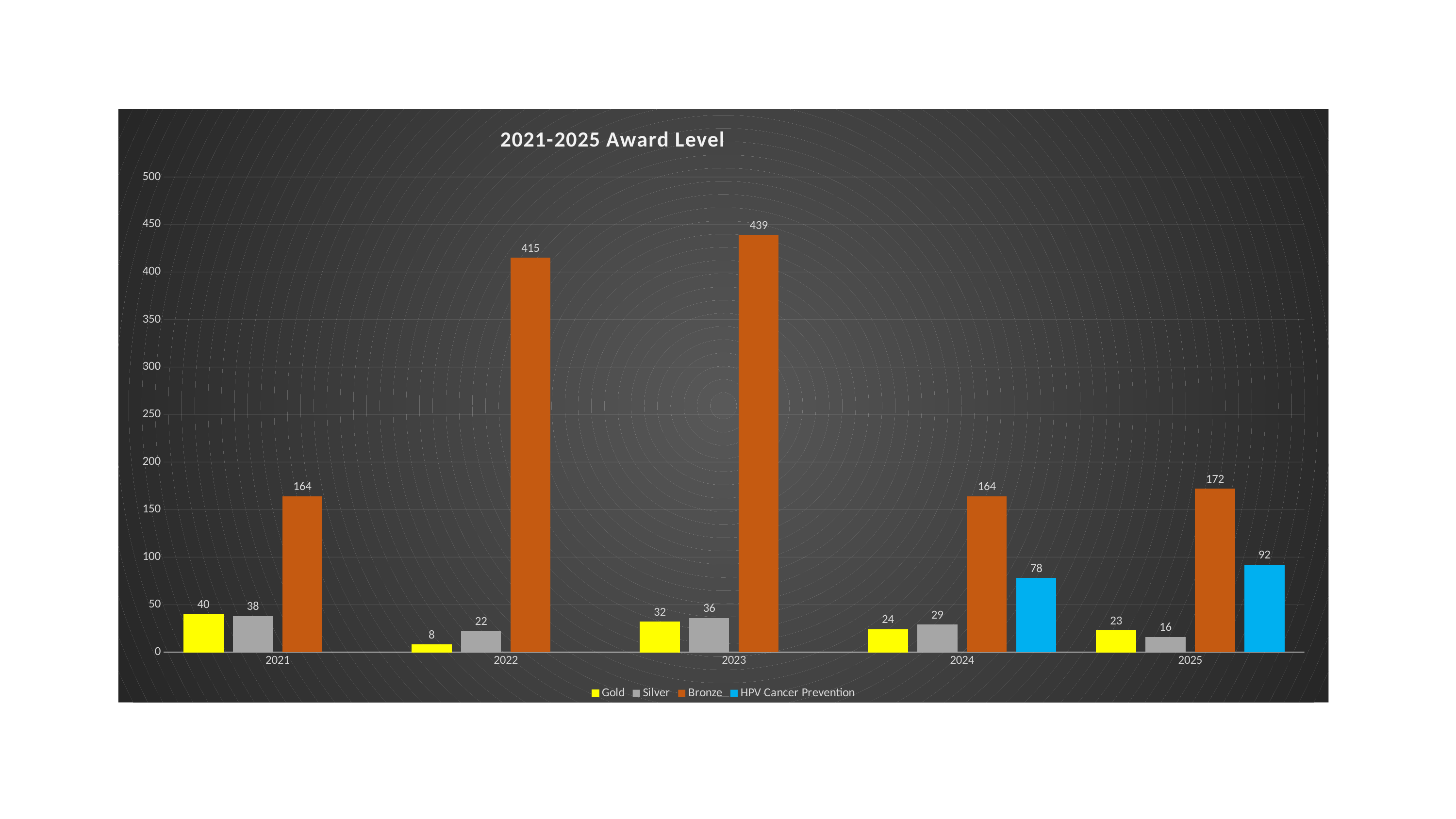
How many years are shown on the x axis? 5 What is the HPV Cancer Prevention value for 2025? 92 What is the title of the chart? 2021-2025 Award Level What kind of chart is shown on the slide? Bar chart In which year is the Gold value lowest? 2022 What is the Bronze value for 2023? 439 What is the Gold value for 2021? 40 Which is larger, the Silver value for 2024 or the Silver value for 2025? Silver value for 2024 How many series does the legend list? 4 In which year is the Bronze value highest? 2023 What is the Silver value for 2022? 22 What is the difference between the Bronze values for 2023 and 2022? 24